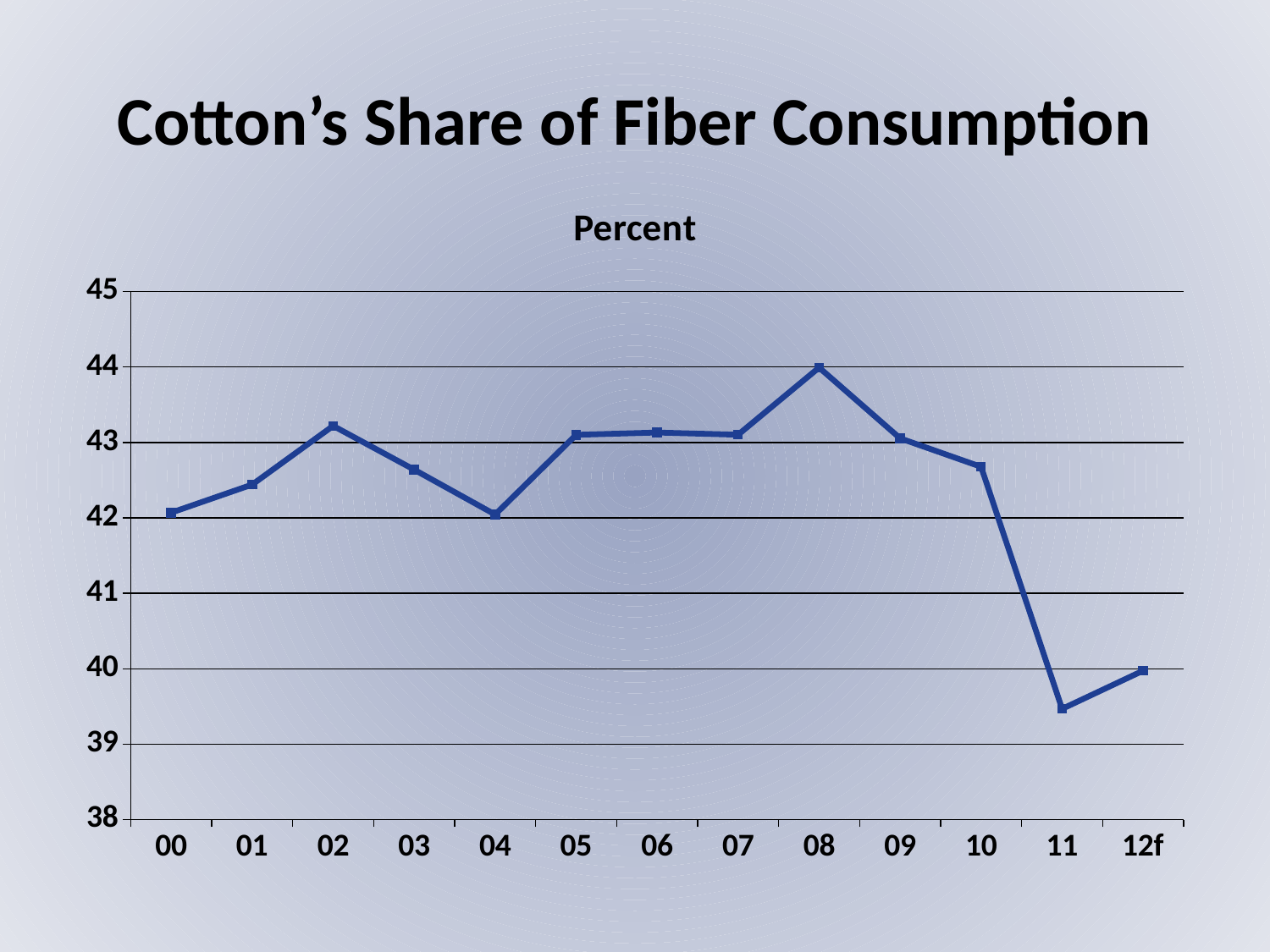
What kind of chart is shown on the slide? line chart Which is larger, the value for 02 or the value for 03? 02 What is the title of the chart? Cotton's Share of Fiber Consumption Is the value for 12f greater or less than 41? less Which year has the lowest cotton share of fiber consumption? 11 Is the value for 08 greater or less than 43? greater Is the value for 11 greater or less than 40? less Does the cotton share rise or fall from 10 to 11? fall What unit label appears above the chart? Percent Which year has the highest cotton share of fiber consumption? 08 How many years are plotted on the x axis? 13